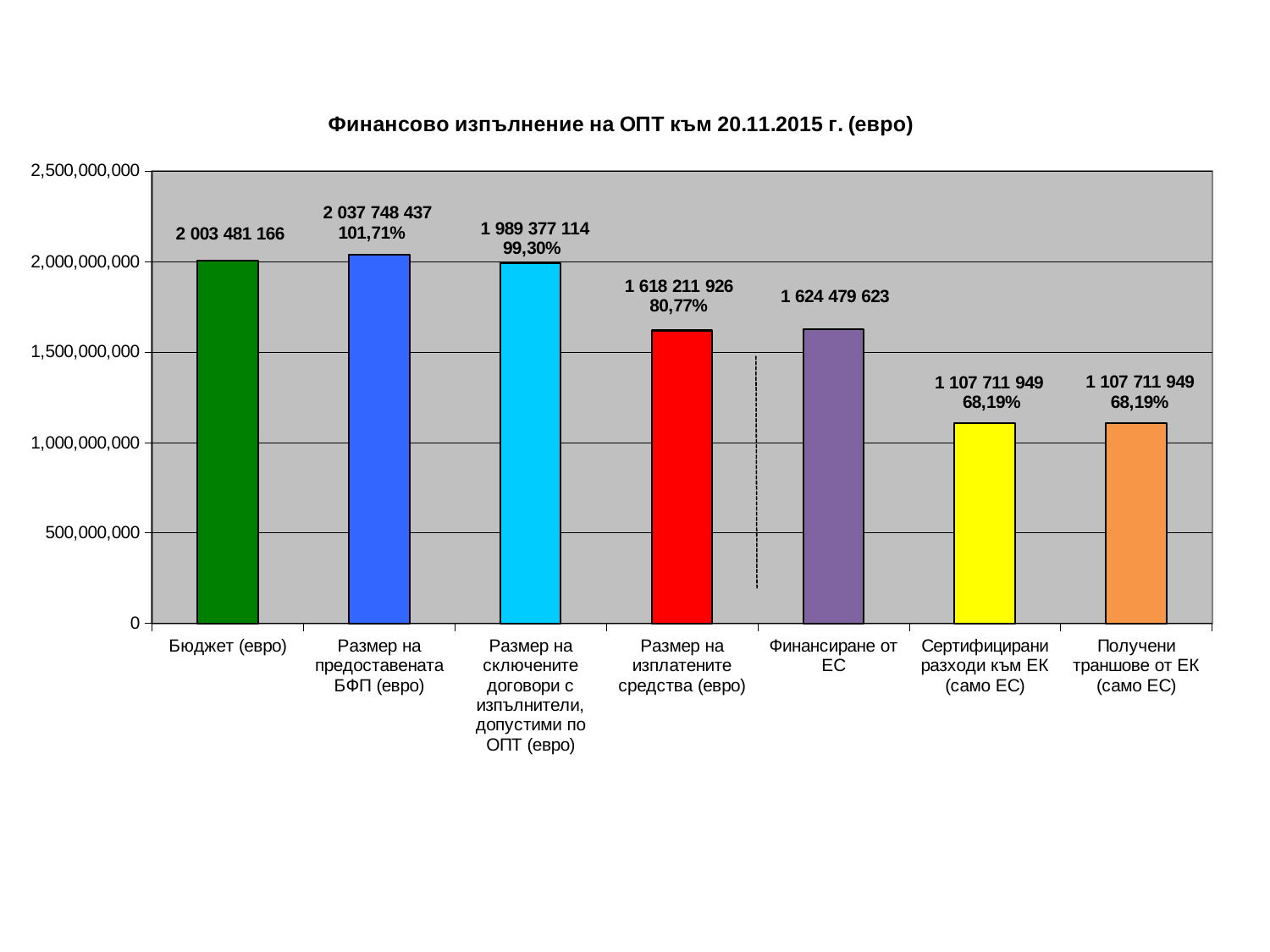
What is the value shown for Финансиране от ЕС? 1 624 479 623 What is the difference between Финансиране от ЕС and Сертифицирани разходи към ЕК (само ЕС)? 516 767 674 What percentage is shown for Сертифицирани разходи към ЕК (само ЕС)? 68,19% What is the value shown for Размер на предоставената БФП (евро)? 2 037 748 437 What is the difference between Размер на предоставената БФП (евро) and Бюджет (евро)? 34 267 271 Which is larger: Финансиране от ЕС or Размер на изплатените средства (евро)? Финансиране от ЕС Is the value for Получени траншове от ЕК (само ЕС) greater or less than 1,000,000,000? greater What percentage is shown above the bar for Размер на изплатените средства (евро)? 80,77% Which category has the highest value? Размер на предоставената БФП (евро) What kind of chart is shown on the slide? bar chart What is the value shown for Бюджет (евро)? 2 003 481 166 How many categories are shown on the chart? 7